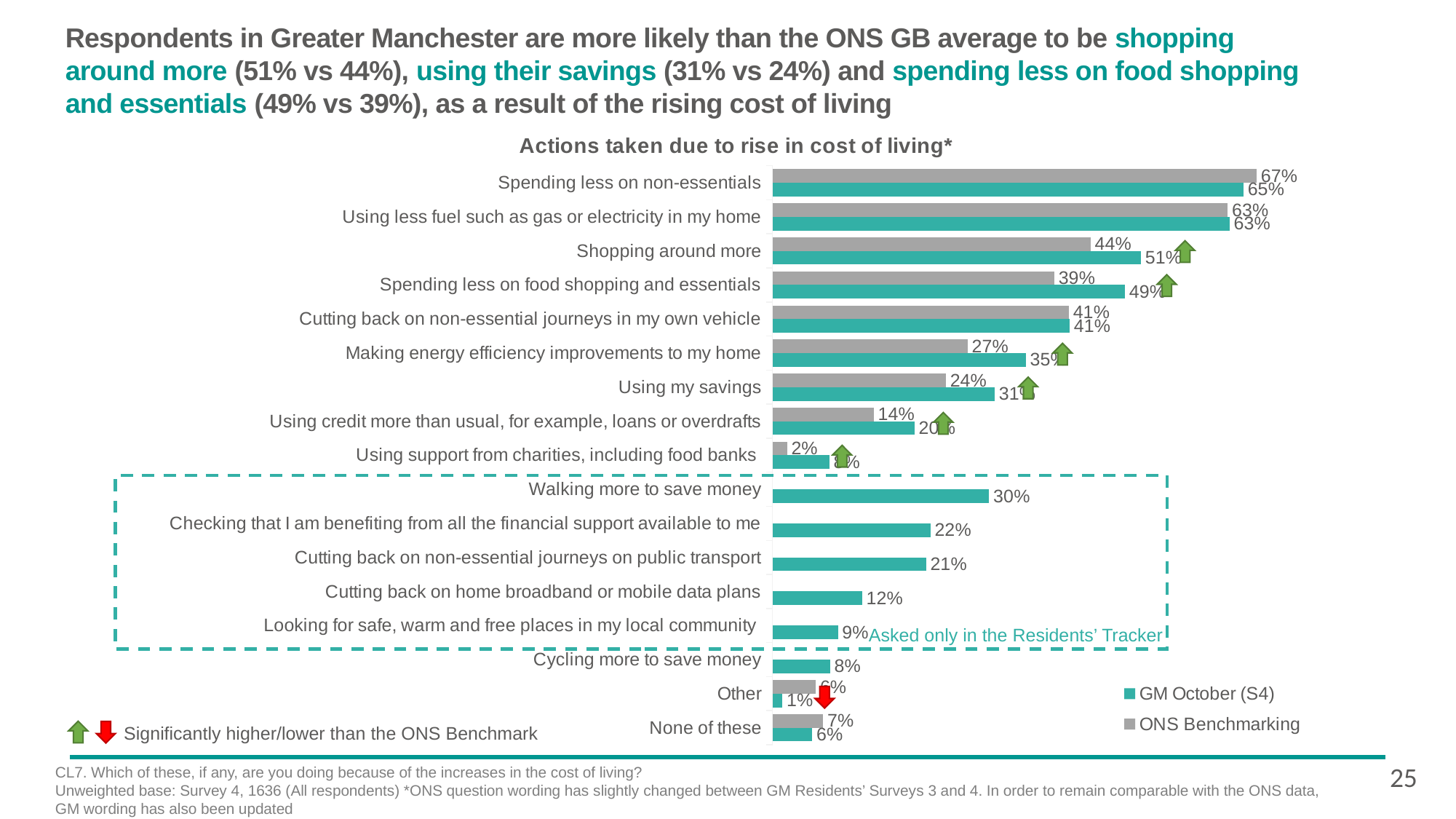
What is the difference between the GM October (S4) and ONS Benchmarking values for Making energy efficiency improvements to my home? 8% What is the ONS Benchmarking value for Using credit more than usual, for example, loans or overdrafts? 14% How many series does the legend list? 2 What is the GM October (S4) value for Cutting back on home broadband or mobile data plans? 12% What is the GM October (S4) value for Walking more to save money? 30% What is the ONS Benchmarking value for Spending less on food shopping and essentials? 39% What is the title of the chart? Actions taken due to rise in cost of living* What kind of chart is shown on the slide? bar chart Which is larger for Using my savings: the GM October (S4) value or the ONS Benchmarking value? GM October (S4) What is the GM October (S4) value for Shopping around more? 51% Which category has the highest GM October (S4) value? Spending less on non-essentials Which category has the lowest GM October (S4) value? Other